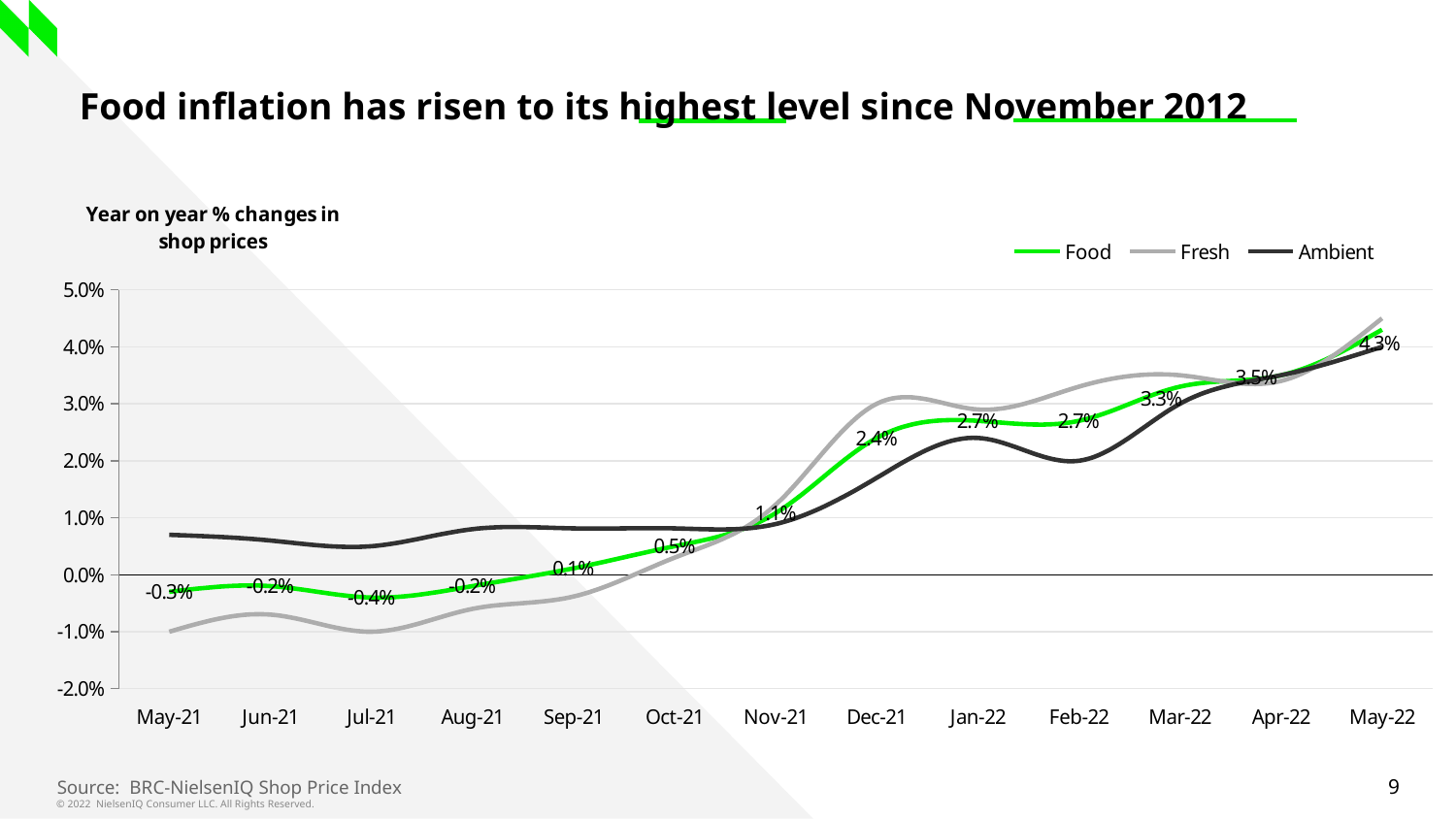
In which month is the Food series at its highest? May-22 How many months are shown on the x axis? 13 What is the Food value for Jul-21? -0.4% What is the Food value for May-22? 4.3% Does the Food series rise or fall from May-21 to May-22? rise What is the Food value for Nov-21? 1.1% Is the Fresh value for May-22 greater or less than 4.0%? greater How many series does the legend list? 3 What is the difference between the Food value in May-22 and the Food value in Nov-21? 3.2% Which is larger, the Food value for Dec-21 or the Food value for Mar-22? Mar-22 In which month is the Food series at its lowest? Jul-21 What type of chart is shown on the slide? line chart